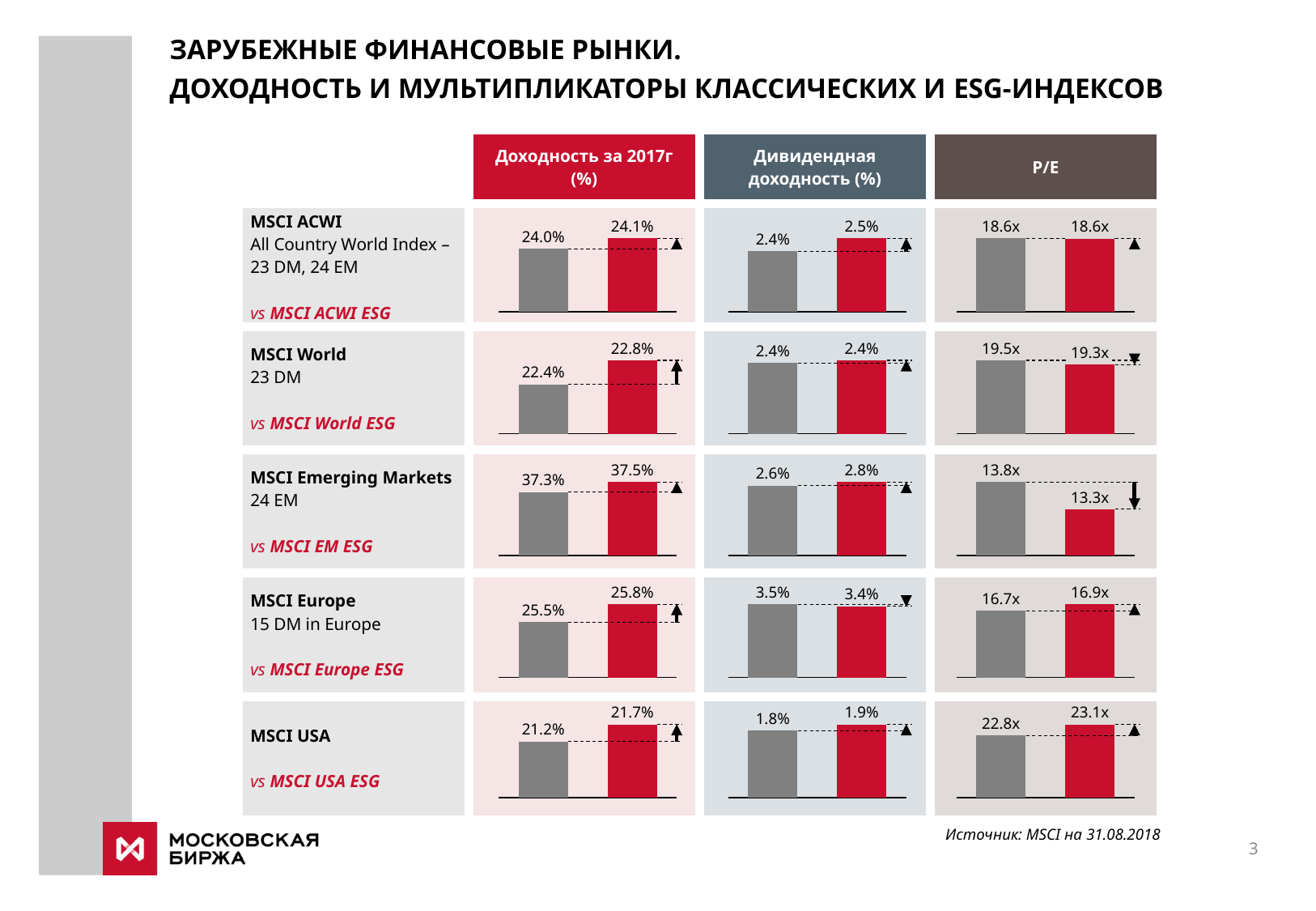
What is the title of the third (rightmost) column of charts? P/E How many bars are shown in each of the small charts on the slide? 2 In the 'P/E' chart for the MSCI Emerging Markets row, what is the value of the red (ESG) bar? 13.3x In the 'Доходность за 2017г (%)' chart for the MSCI USA row, what is the difference between the red bar and the grey bar? 0.5% In the 'P/E' chart for the MSCI World row, which bar is larger, the grey bar or the red bar? the grey bar In the 'P/E' chart for the MSCI Emerging Markets row, what is the difference between the grey bar and the red bar? 0.5x What kind of chart is used in the 'Доходность за 2017г (%)' column? bar chart In the 'P/E' chart for the MSCI USA row, what is the value of the grey bar? 22.8x In the 'Дивидендная доходность (%)' chart for the MSCI Emerging Markets row, which bar is larger, the grey bar or the red bar? the red bar In the 'Дивидендная доходность (%)' chart for the MSCI Europe row, what is the value of the grey bar? 3.5% In the 'Доходность за 2017г (%)' chart for the MSCI ACWI row, what is the value of the red (ESG) bar? 24.1% In the 'Доходность за 2017г (%)' chart for the MSCI World row, what is the value of the grey (classic index) bar? 22.4%